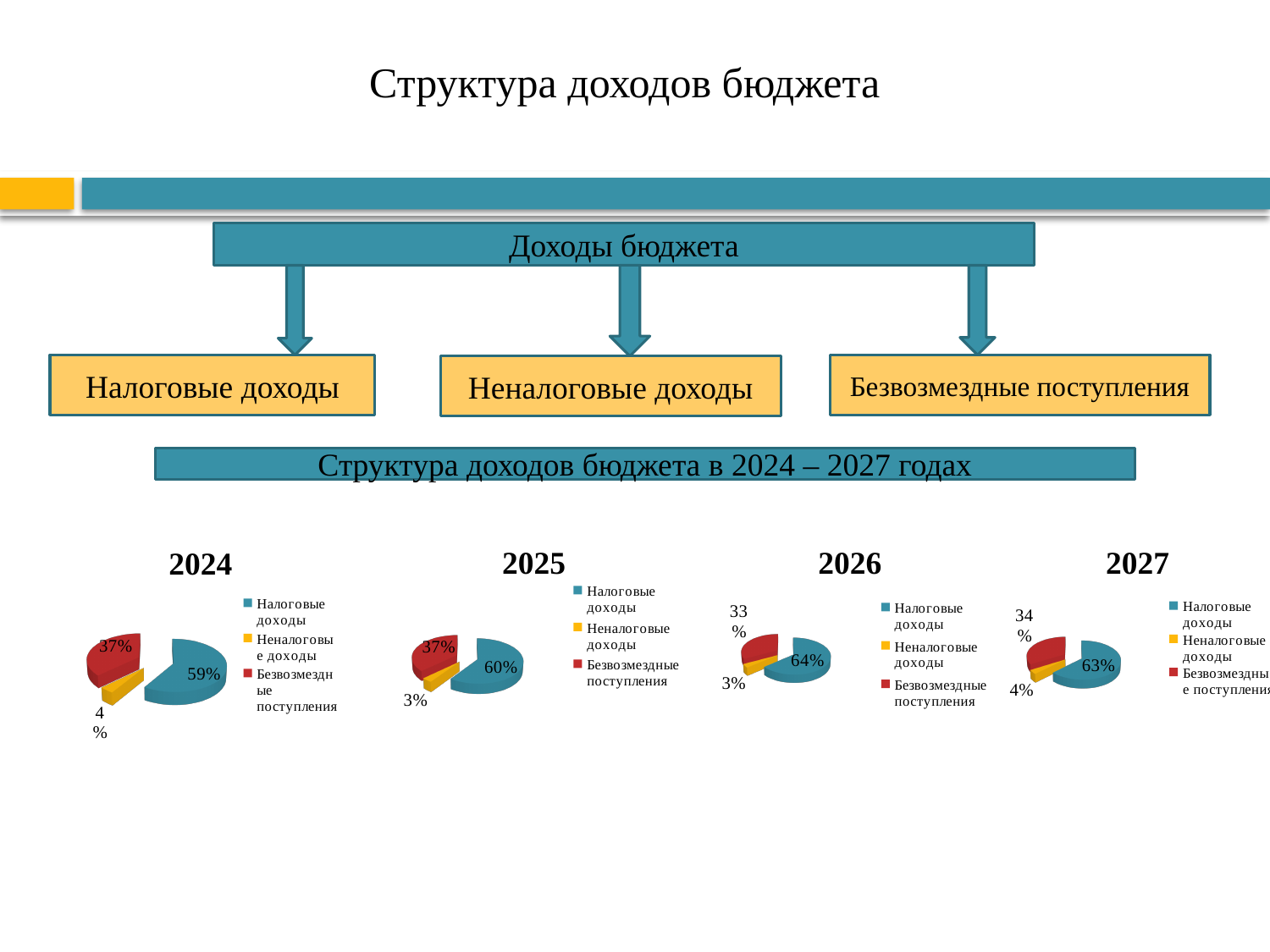
In the 2024 pie chart, what share is Налоговые доходы? 59% In the 2026 pie chart, what share is Налоговые доходы? 64% In the 2027 pie chart, what share is Безвозмездные поступления? 34% In the 2025 pie chart, what is the difference between the shares of Налоговые доходы and Безвозмездные поступления? 23% What type of chart is used for the 2024 data? Pie chart In the 2025 pie chart, what share is Неналоговые доходы? 3% How many slices does the 2025 pie chart have? 3 Which is larger: the share of Налоговые доходы in 2024 or in 2026? 2026 In the 2027 pie chart, which category has the largest share? Налоговые доходы In the 2026 pie chart, which category has the smallest share? Неналоговые доходы In the 2024 pie chart, what share is Безвозмездные поступления? 37% How many entries does the legend of the 2027 chart list? 3